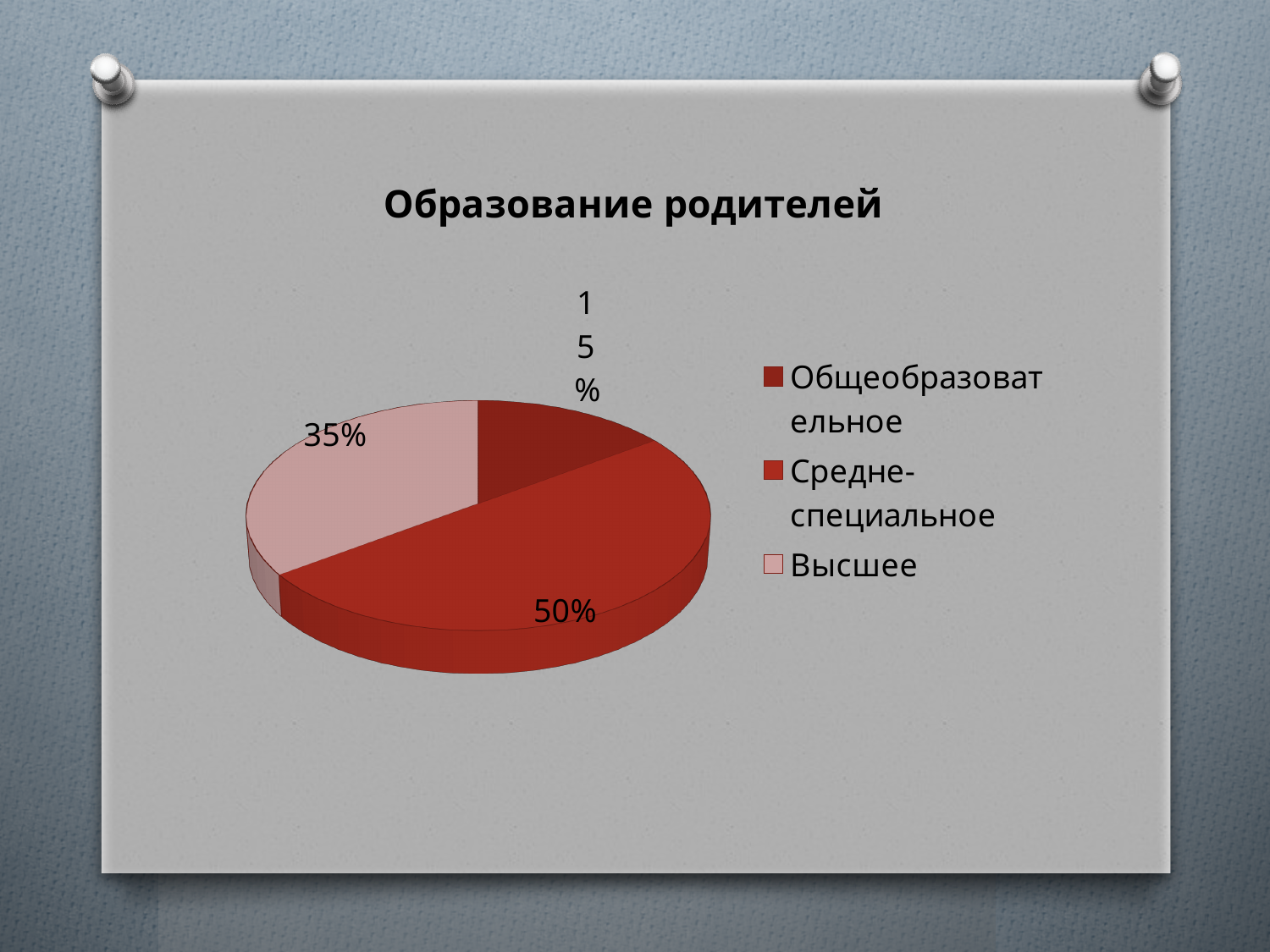
Which category has the largest slice of the pie? Средне-специальное What kind of chart is shown on the slide? pie chart What is the title of the chart? Образование родителей What share of the pie does Средне-специальное take? 50% Which legend entry is shown with the lightest colour? Высшее What share of the pie does Высшее take? 35% What share of the pie does Общеобразовательное take? 15% What is the difference between the shares for Высшее and Общеобразовательное? 20% What is the difference between the shares for Средне-специальное and Высшее? 15% How many categories does the pie chart show? 3 Which is larger, the share for Высшее or the share for Общеобразовательное? Высшее Which category has the smallest slice of the pie? Общеобразовательное